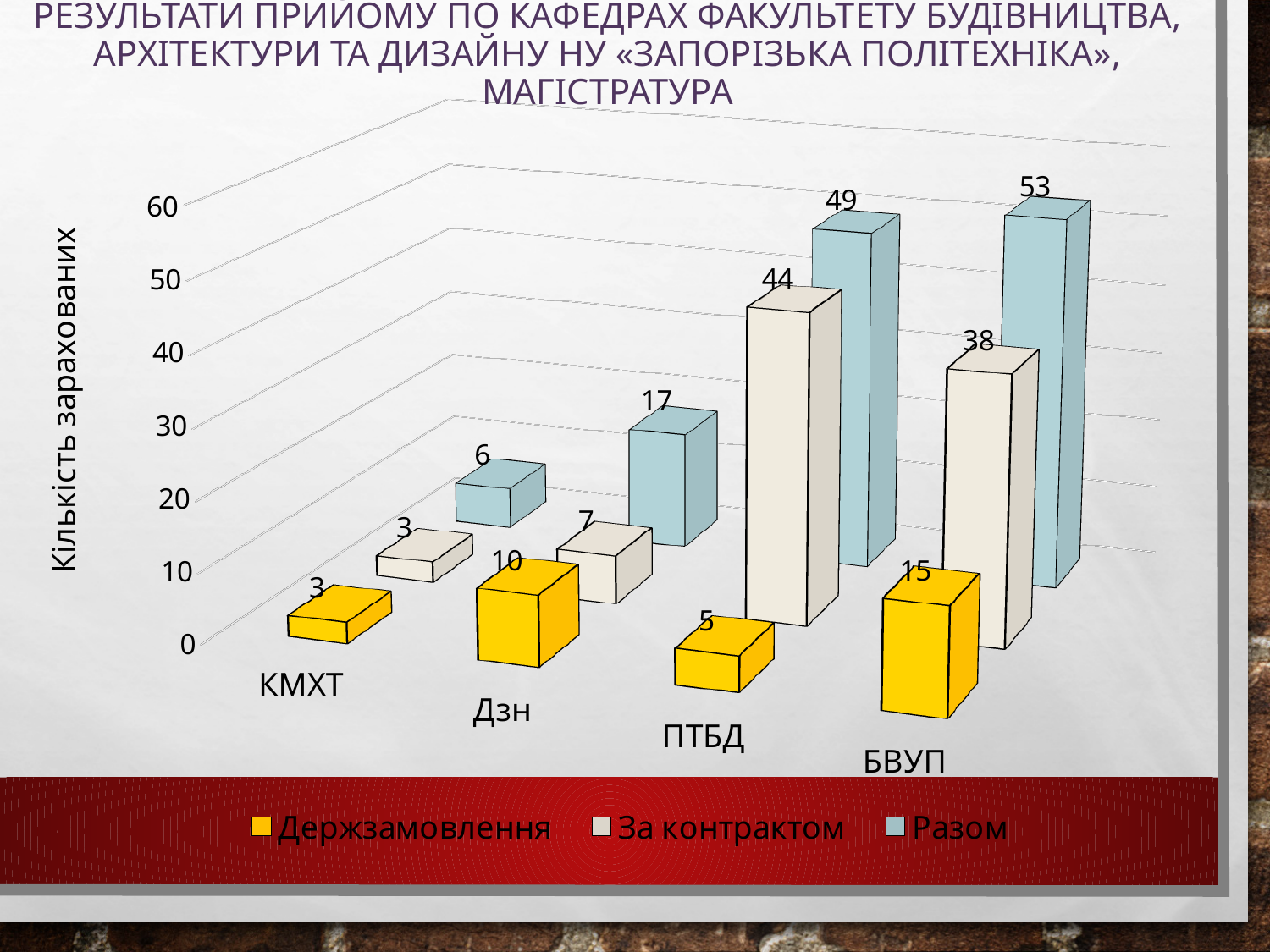
How many series does the legend list? 3 What is the label of the vertical axis? Кількість зарахованих What is the value of Держзамовлення for БВУП? 15 How many categories are shown on the x axis? 4 What is the value of Разом for Дзн? 17 Which is larger: За контрактом for ПТБД or За контрактом for БВУП? ПТБД Which colour represents the Держзамовлення series in the legend? yellow Which category has the lowest Разом value? КМХТ What is the value of За контрактом for ПТБД? 44 What is the difference between the Разом values for БВУП and ПТБД? 4 Which category has the highest Разом value? БВУП What kind of chart is shown on the slide? bar chart